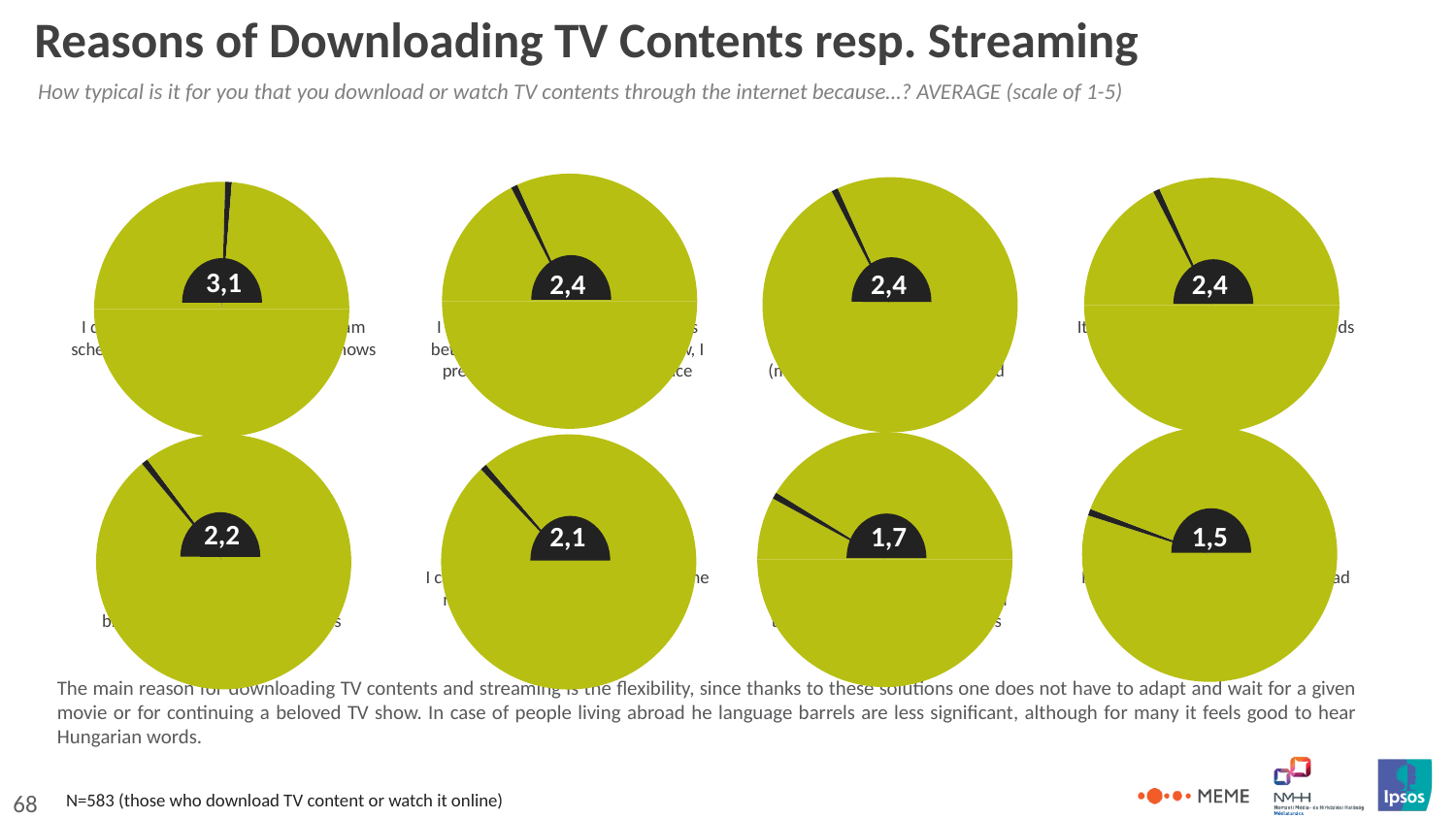
What value is shown on the bottom-right chart? 1,5 What is the difference between the value on the top-left chart and the value on the bottom-right chart? 1,6 What value is shown on the third chart from the left in the bottom row? 1,7 What value is shown on the top-left chart? 3,1 What value is shown on the second chart from the left in the bottom row? 2,1 How many charts are shown on the slide? 8 Which chart shows the lowest value on the slide? The bottom-right chart (1,5) Which is larger: the value on the bottom-left chart or the value on the third chart from the left in the bottom row? The bottom-left chart (2,2) What is the title of the slide? Reasons of Downloading TV Contents resp. Streaming Which chart shows the highest value on the slide? The top-left chart (3,1) What value is shown on the bottom-left chart? 2,2 What value is shown on the top-right chart? 2,4